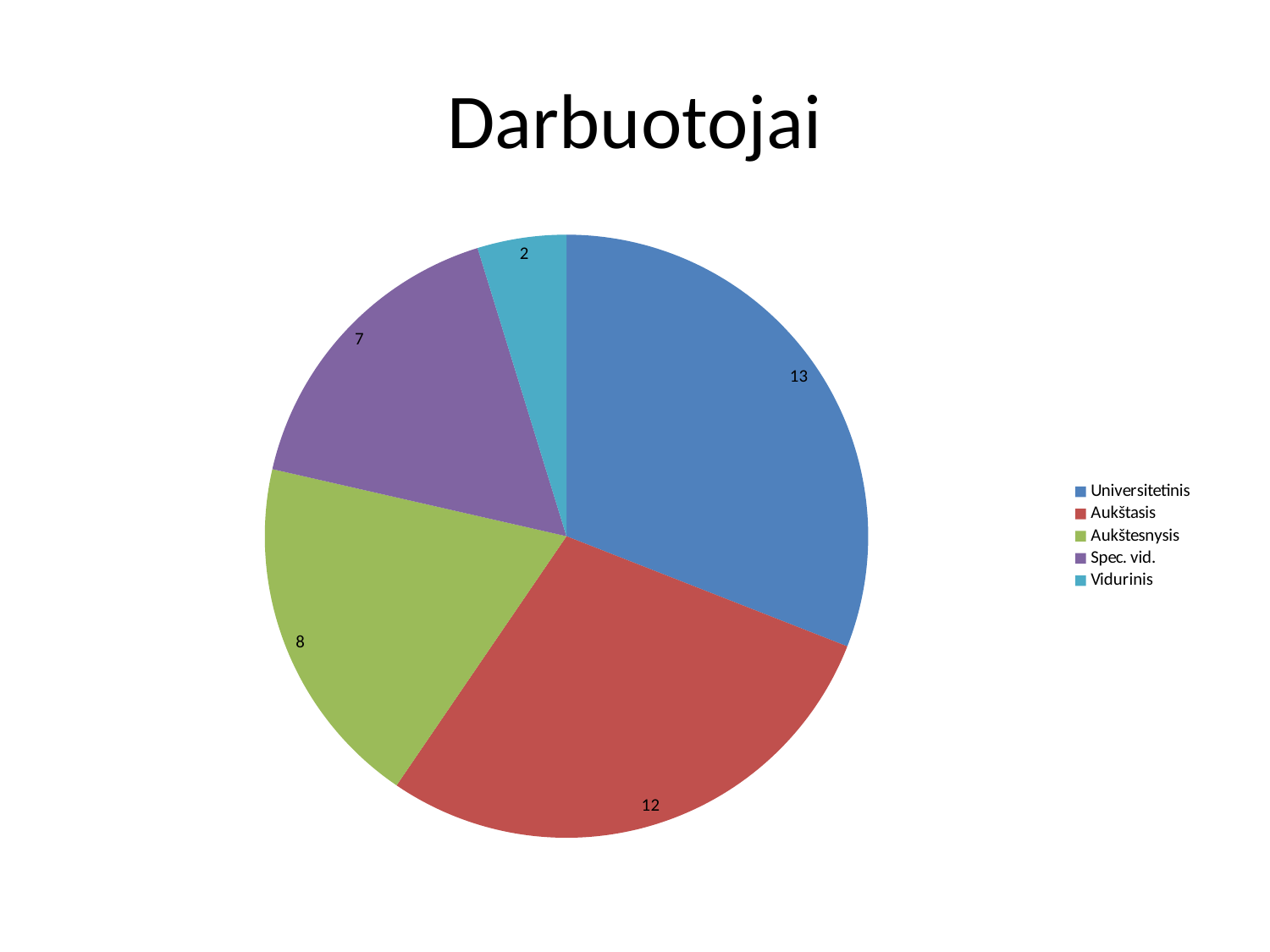
Which category has the smallest slice? Vidurinis What is the value for Spec. vid.? 7 How many categories does the pie chart have? 5 What is the value for Universitetinis? 13 What is the value for Aukštesnysis? 8 What is the value for Vidurinis? 2 Which category has the largest slice? Universitetinis What is the title of the chart? Darbuotojai What is the difference between the values for Universitetinis and Vidurinis? 11 Which is larger, the value for Aukštesnysis or the value for Spec. vid.? Aukštesnysis What is the value for Aukštasis? 12 What type of chart is shown on the slide? pie chart